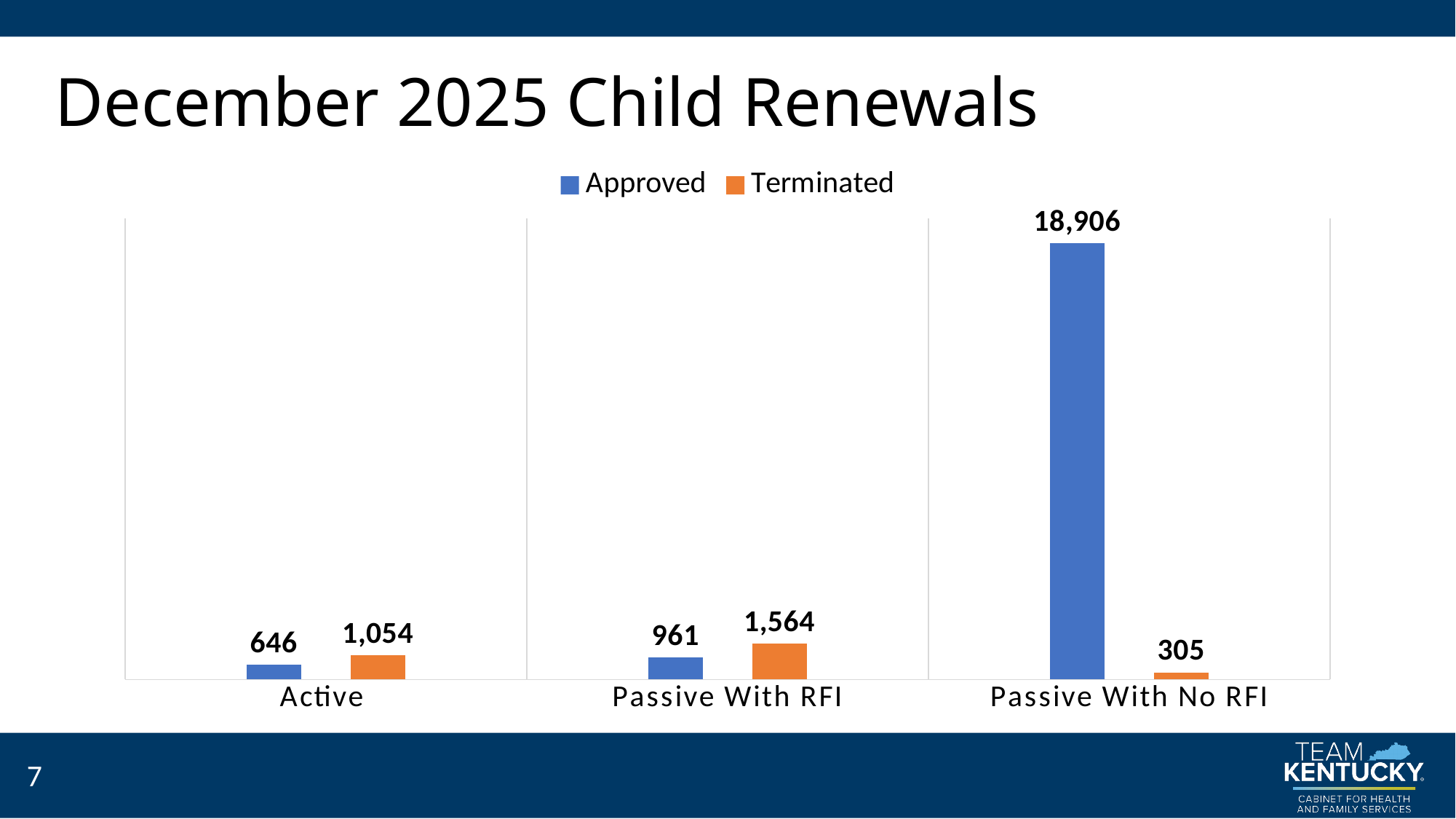
What is the Terminated value for Passive With RFI? 1,564 How many categories are shown on the x axis? 3 For Passive With RFI, which is larger: Approved or Terminated? Terminated What is the difference between the Terminated and Approved values for Active? 408 Which category has the highest Approved value? Passive With No RFI Which category has the lowest Terminated value? Passive With No RFI What is the Approved value for Active? 646 What kind of chart is shown on the slide? Bar chart How many series does the legend list? 2 What is the Approved value for Passive With No RFI? 18,906 What is the difference between the Approved and Terminated values for Passive With No RFI? 18,601 What is the Terminated value for Passive With No RFI? 305